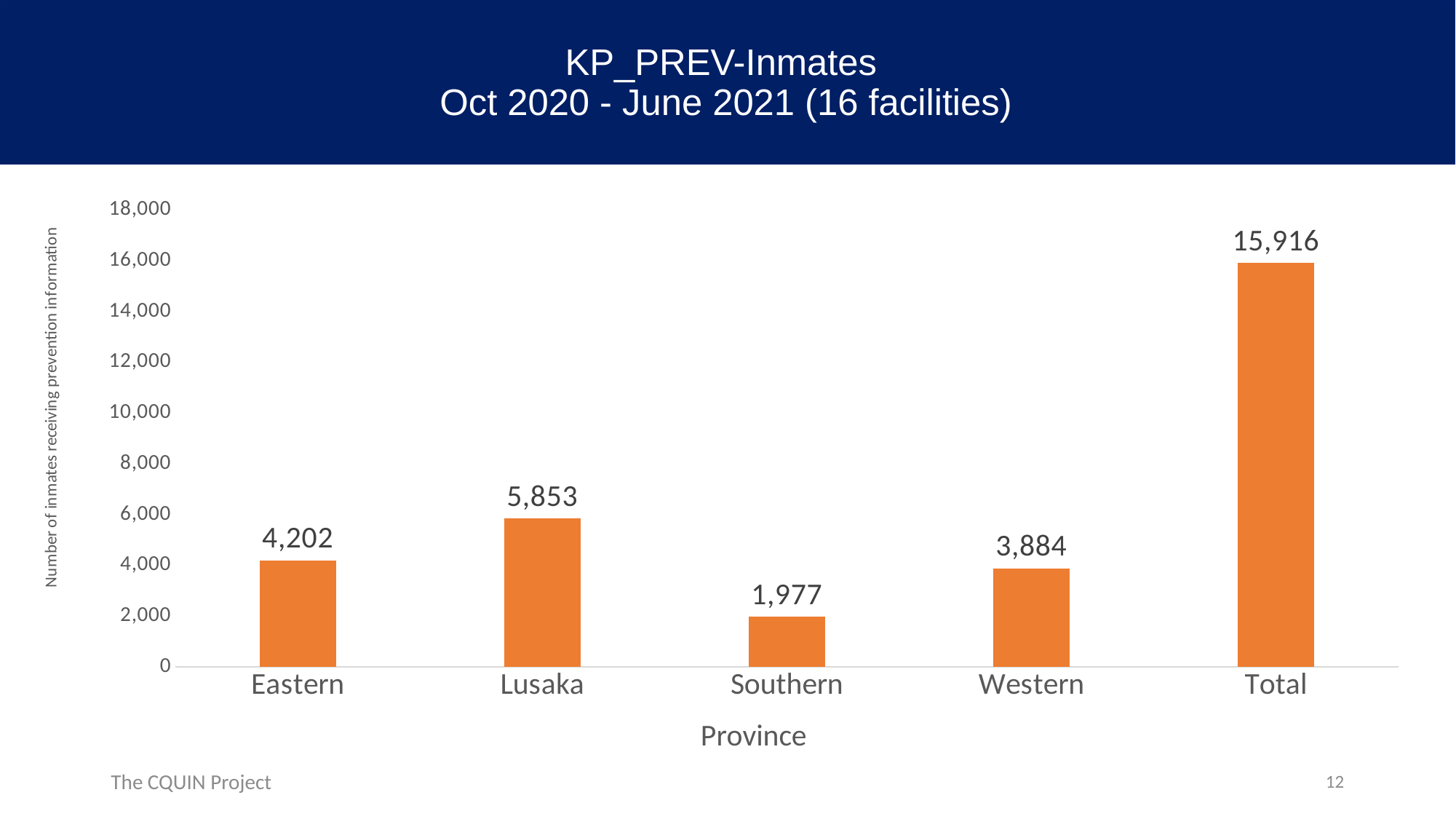
Which province (excluding Total) has the highest value? Lusaka Is the value for Total greater or less than 14,000? greater Which category has the lowest value? Southern Which is larger, the value for Eastern or the value for Western? Eastern What is the value for Southern? 1,977 How many bars are shown in the chart? 5 What is the value for Lusaka? 5,853 What is the difference between the values for Lusaka and Eastern? 1,651 What is the label of the x axis? Province What is the value shown for Total? 15,916 What is the value for Western? 3,884 What kind of chart is shown on the slide? bar chart